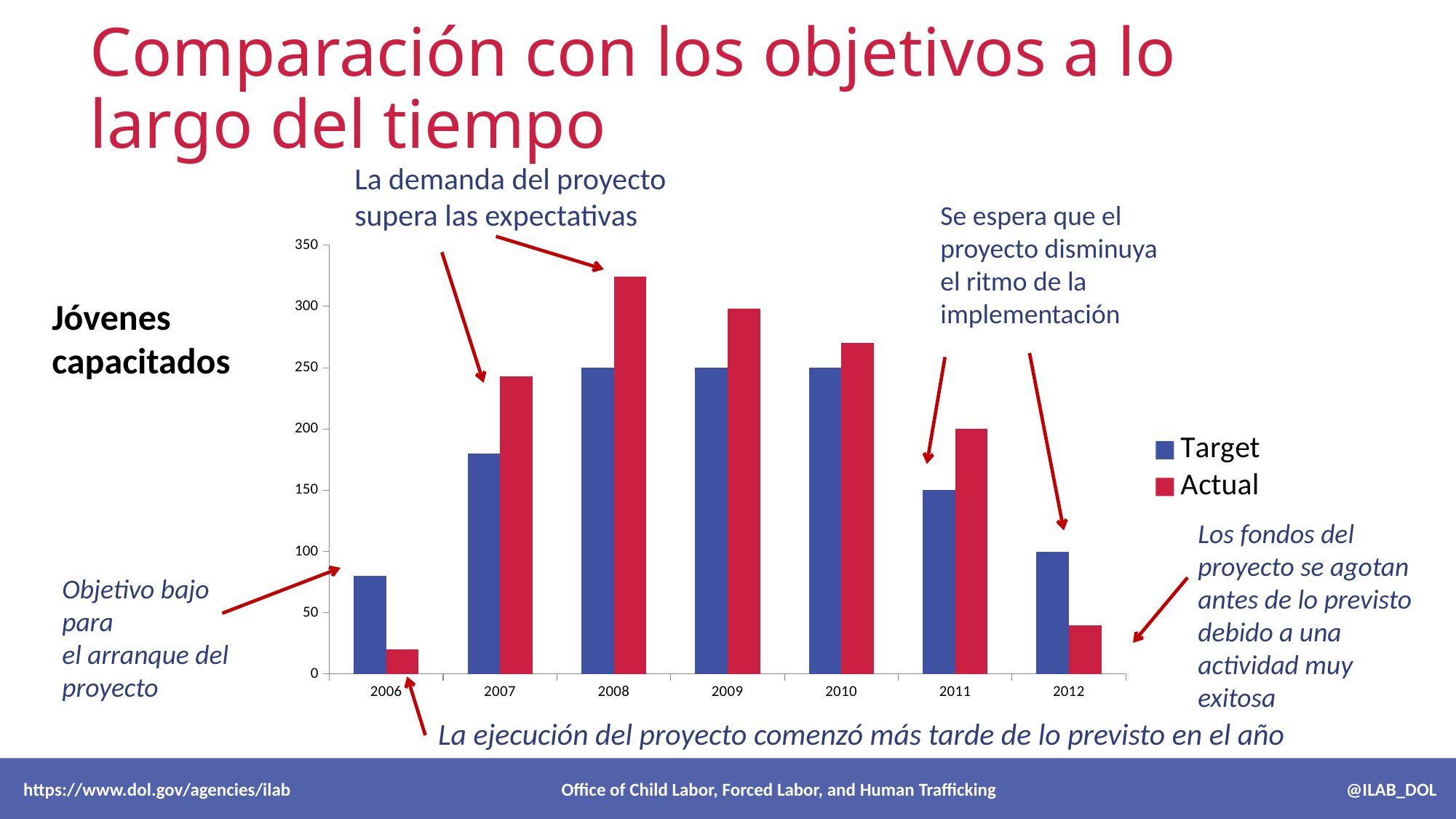
In 2006, which is larger, Target or Actual? Target In which year is the Actual value lowest? 2006 How many years are shown on the x axis? 7 In which year is the Actual value highest? 2008 Do the Actual values rise or fall from 2008 to 2012? fall In 2008, which is larger, Target or Actual? Actual How many series does the legend list? 2 What are the two entries in the chart legend? Target and Actual Is the Target value for 2007 greater or less than 150? greater What kind of chart is shown on the slide? bar chart Is the Actual value for 2008 greater or less than 300? greater Is the Actual value for 2006 greater or less than 50? less